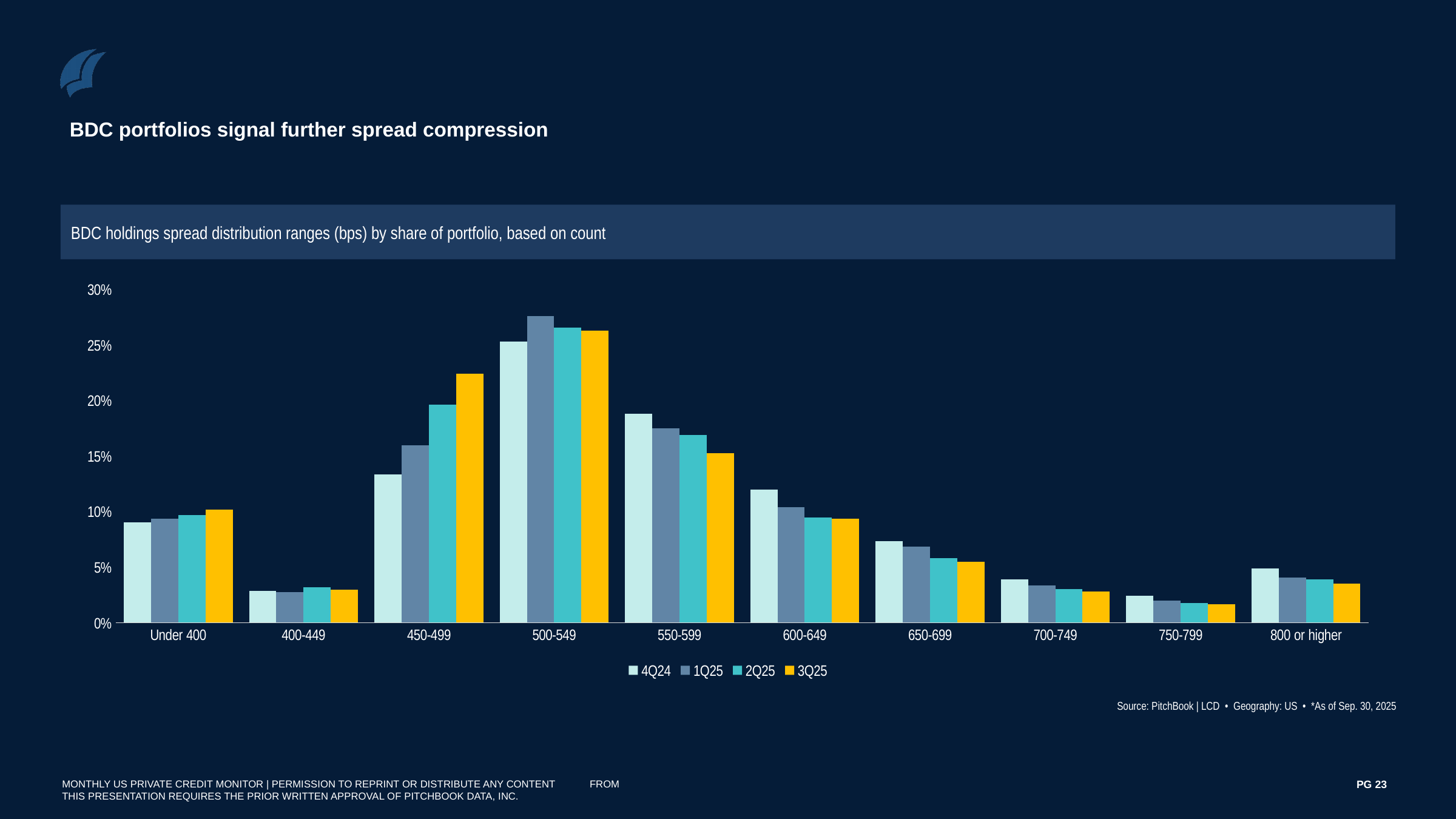
How many spread range categories are shown on the x axis? 10 Which spread range has the lowest 4Q24 bar? 750-799 For the 450-499 range, which is larger: the 4Q24 value or the 3Q25 value? 3Q25 Within the 600-649 range, do the bars rise or fall from 4Q24 to 3Q25? fall Is the 1Q25 value for 500-549 greater or less than 25%? greater Which spread range has the highest 3Q25 bar? 500-549 For the 550-599 range, which is larger: the 4Q24 value or the 3Q25 value? 4Q24 Is the 4Q24 value for 450-499 greater or less than 15%? less How many series does the legend list? 4 What are the four legend entries of the chart? 4Q24, 1Q25, 2Q25, 3Q25 What kind of chart is shown on the slide? Bar chart Is the 3Q25 value for 450-499 greater or less than 20%? greater